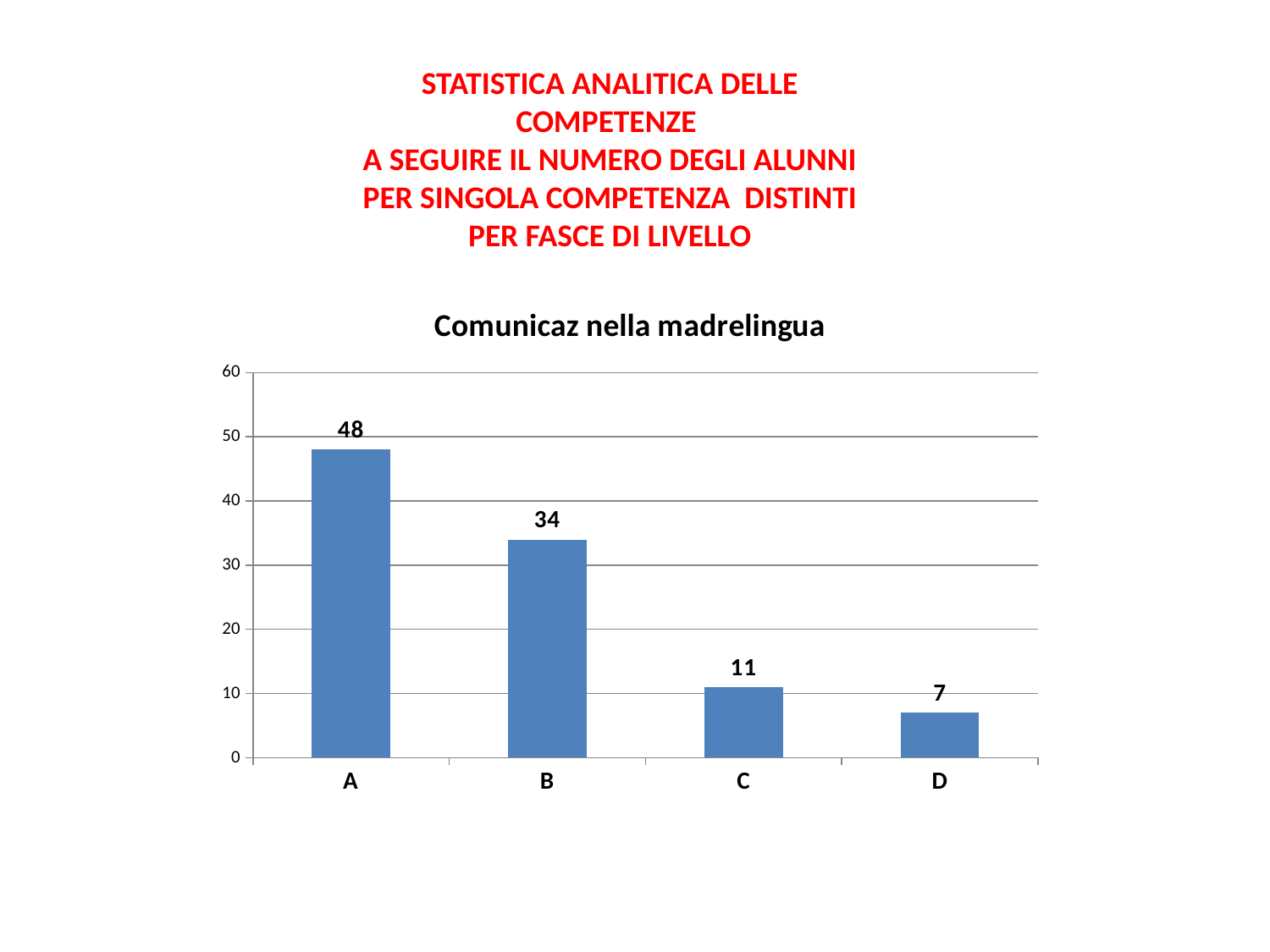
What is the value for category D? 7 Which category has the highest value? A Is the value for B greater or less than 30? greater What is the title of the chart? Comunicaz nella madrelingua What is the value for category C? 11 What kind of chart is shown? bar chart What is the value for category B? 34 Which is larger, the value for C or the value for D? C What is the value for category A? 48 How many categories are shown on the x axis? 4 What is the difference between the values for A and B? 14 Which category has the lowest value? D